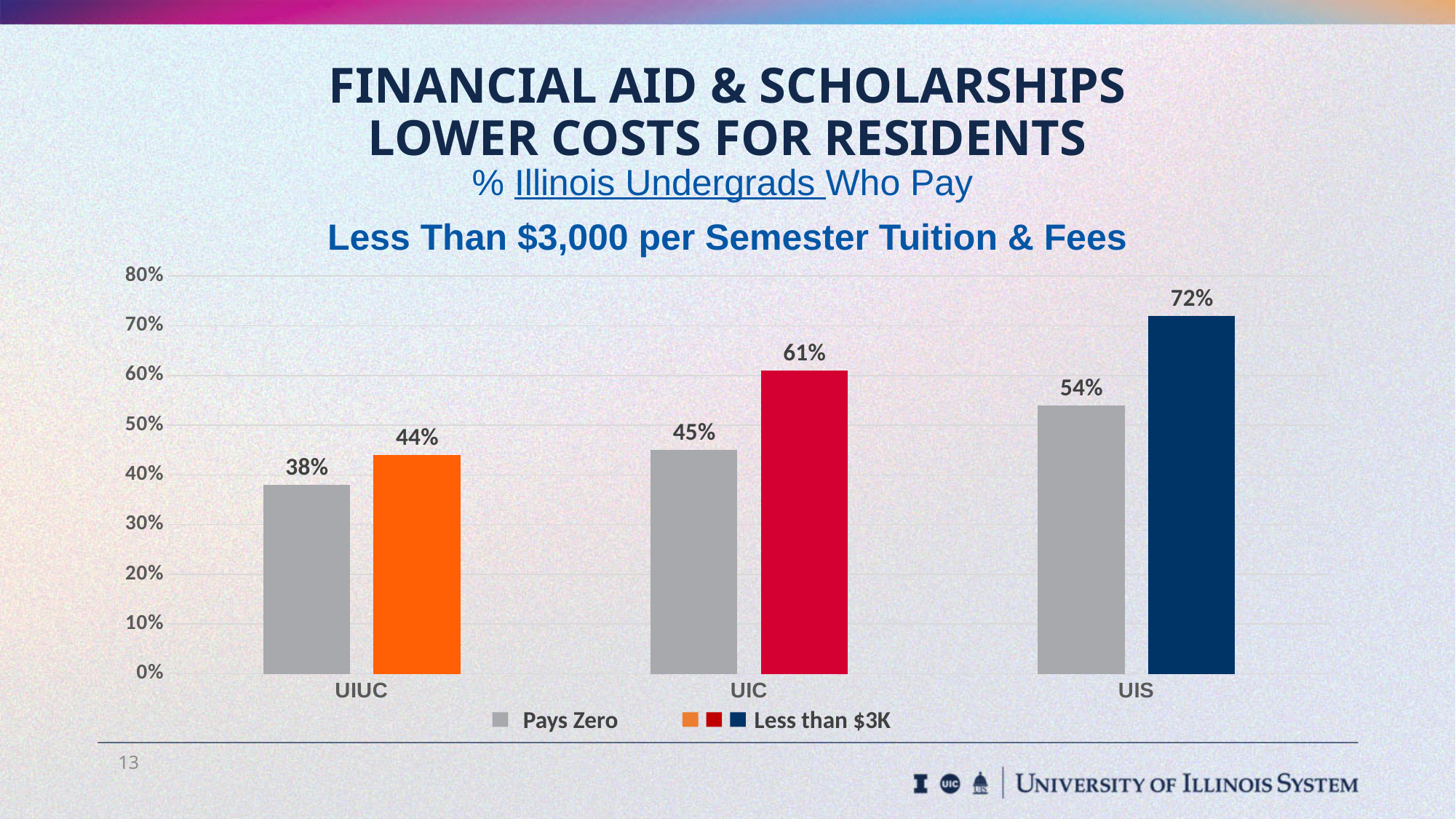
How many campuses are shown on the x axis? 3 What is the difference between the 'Less than $3K' values for UIC and UIUC? 17% Which is larger: the 'Pays Zero' value for UIS or the 'Less than $3K' value for UIUC? Pays Zero for UIS What kind of chart is shown on the slide? Bar chart What percentage of Illinois undergrads at UIS pay less than $3K per semester? 72% Which campus has the lowest 'Pays Zero' percentage? UIUC What is the 'Pays Zero' value for UIC? 45% What percentage of Illinois undergrads at UIUC pay zero tuition and fees? 38% How many series does the legend list? 2 What colour are the 'Pays Zero' bars? Gray What is the difference between the 'Less than $3K' and 'Pays Zero' values for UIS? 18% Which campus has the highest share of Illinois undergrads paying less than $3K? UIS